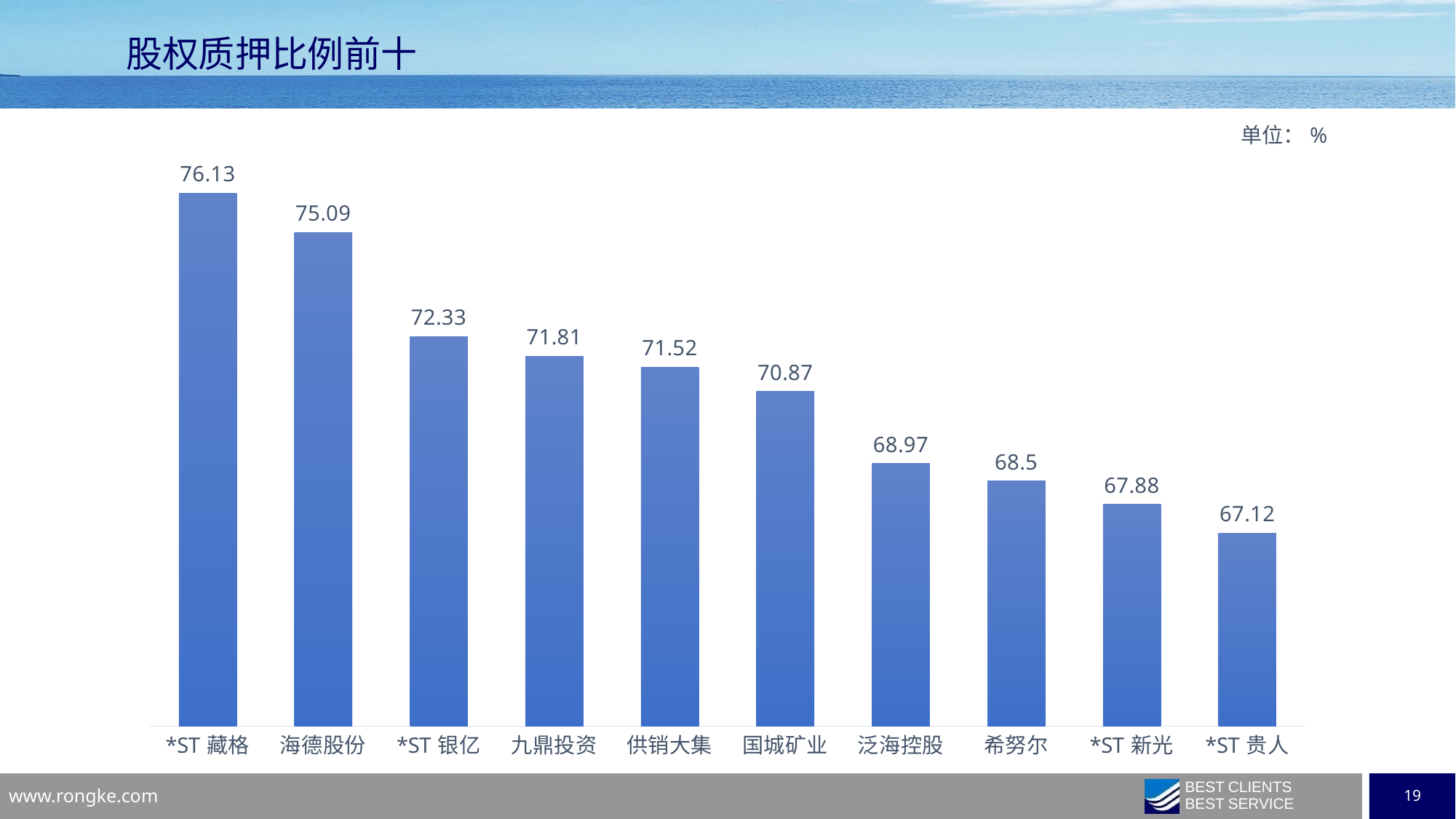
How many categories are shown in the chart? 10 What is the value for 海德股份? 75.09 Which is larger, the value for 供销大集 or the value for 泛海控股? 供销大集 Which category has the highest value? *ST 藏格 What kind of chart is shown on the slide? bar chart Which category has the lowest value? *ST 贵人 Do the values rise or fall from left to right along the x axis? fall What is the title of the chart? 股权质押比例前十 What is the value for 希努尔? 68.5 What is the difference between the values for *ST 银亿 and 九鼎投资? 0.52 What is the difference between the values for *ST 藏格 and *ST 贵人? 9.01 What is the value for 国城矿业? 70.87